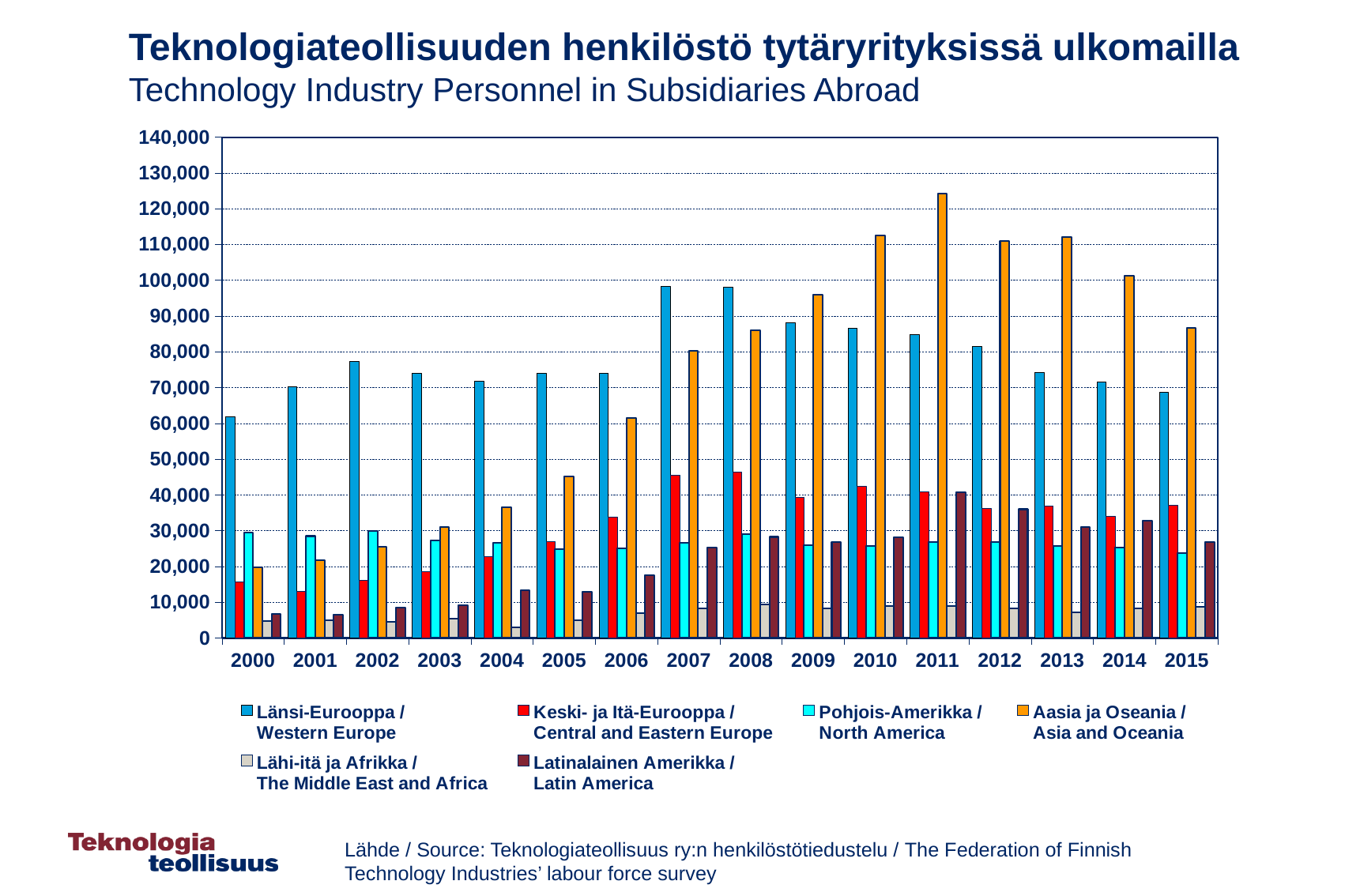
How many series does the legend list? 6 In which year is the value for Asia and Oceania the highest? 2011 Is the value for Asia and Oceania in 2000 greater or less than 30,000? less How many years are shown on the x axis of the chart? 16 What kind of chart is shown on the slide? bar chart In 2011, which is larger: the value for Western Europe or the value for Asia and Oceania? Asia and Oceania Which series has the lowest value in 2015? The Middle East and Africa In 2000, which is larger: the value for Western Europe or the value for Asia and Oceania? Western Europe Do the values for Asia and Oceania rise or fall from 2000 to 2011? rise What is the English title of the chart? Technology Industry Personnel in Subsidiaries Abroad Is the value for Western Europe in 2007 greater or less than 90,000? greater Is the value for Latin America in 2011 greater or less than 30,000? greater